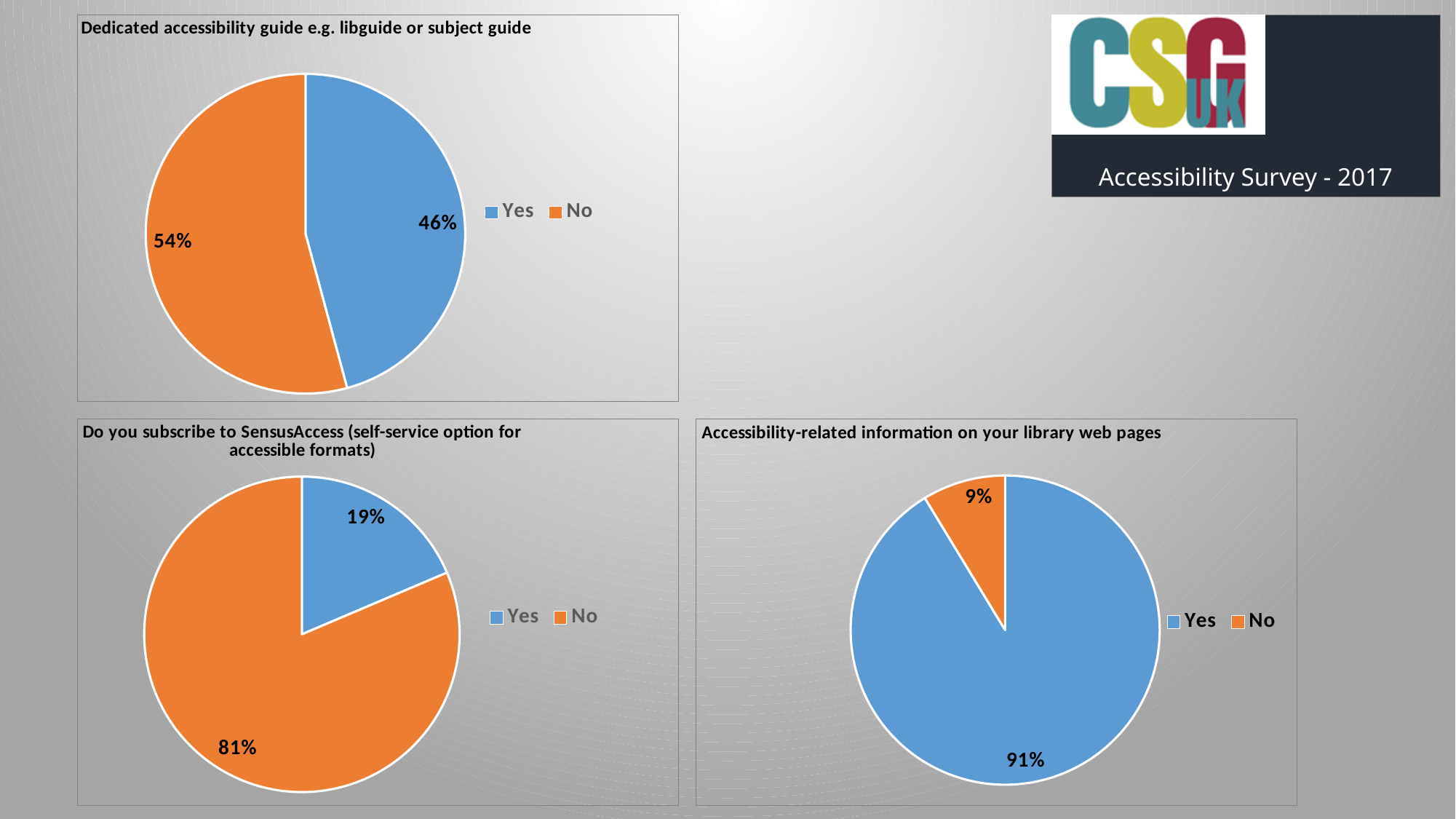
In the 'Accessibility-related information on your library web pages' chart, what share of the pie is No? 9% In the 'Accessibility-related information on your library web pages' chart, which response is the smallest slice? No In the 'Dedicated accessibility guide e.g. libguide or subject guide' chart, what percentage answered No? 54% In the 'Do you subscribe to SensusAccess' chart, what is the difference between the No and Yes percentages? 62% In the 'Accessibility-related information on your library web pages' chart, what percentage answered Yes? 91% How many entries does the legend list in the 'Dedicated accessibility guide e.g. libguide or subject guide' chart? 2 In the 'Do you subscribe to SensusAccess' chart, what percentage answered No? 81% What type of chart is used in the 'Accessibility-related information on your library web pages' chart? Pie chart In the 'Dedicated accessibility guide e.g. libguide or subject guide' chart, what is the difference between the No and Yes percentages? 8% In the 'Dedicated accessibility guide e.g. libguide or subject guide' chart, what percentage answered Yes? 46% In the 'Do you subscribe to SensusAccess' chart, what share of the pie is Yes? 19% In the 'Do you subscribe to SensusAccess' chart, which response is the largest slice? No